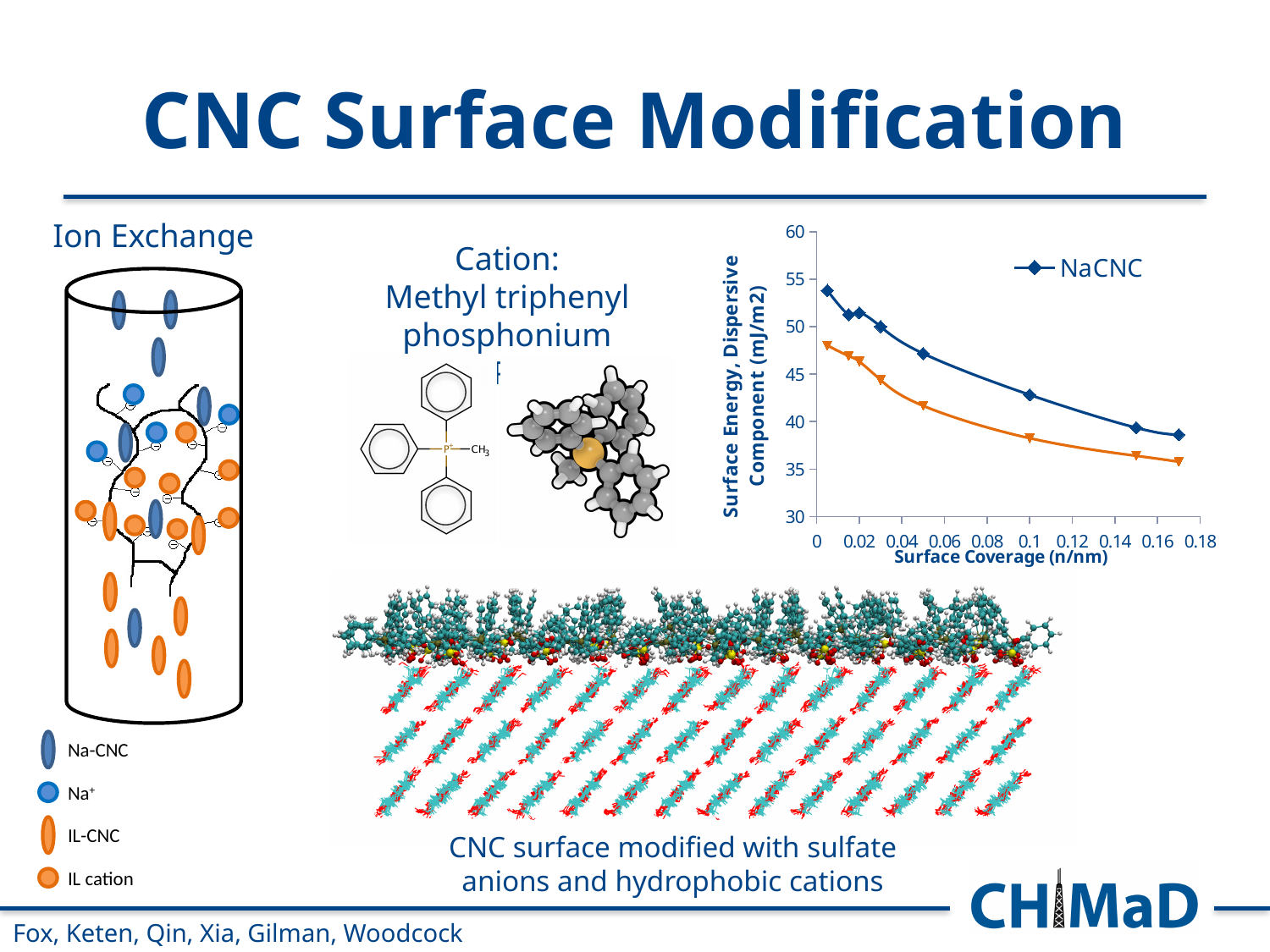
Do the NaCNC values rise or fall as surface coverage increases? fall Is the NaCNC value at a surface coverage of 0.17 greater or less than 40? less At a surface coverage of 0.1, which series has the higher surface energy, NaCNC or the orange series? NaCNC What kind of chart is shown on the slide? line chart Is the NaCNC value at a surface coverage of 0.1 greater or less than 40? greater Is the orange series value at a surface coverage of 0.05 greater or less than 45? less What is the label of the chart's x axis? Surface Coverage (n/nm) How many data points are plotted for the NaCNC series? 8 Which series is named in the chart's legend? NaCNC